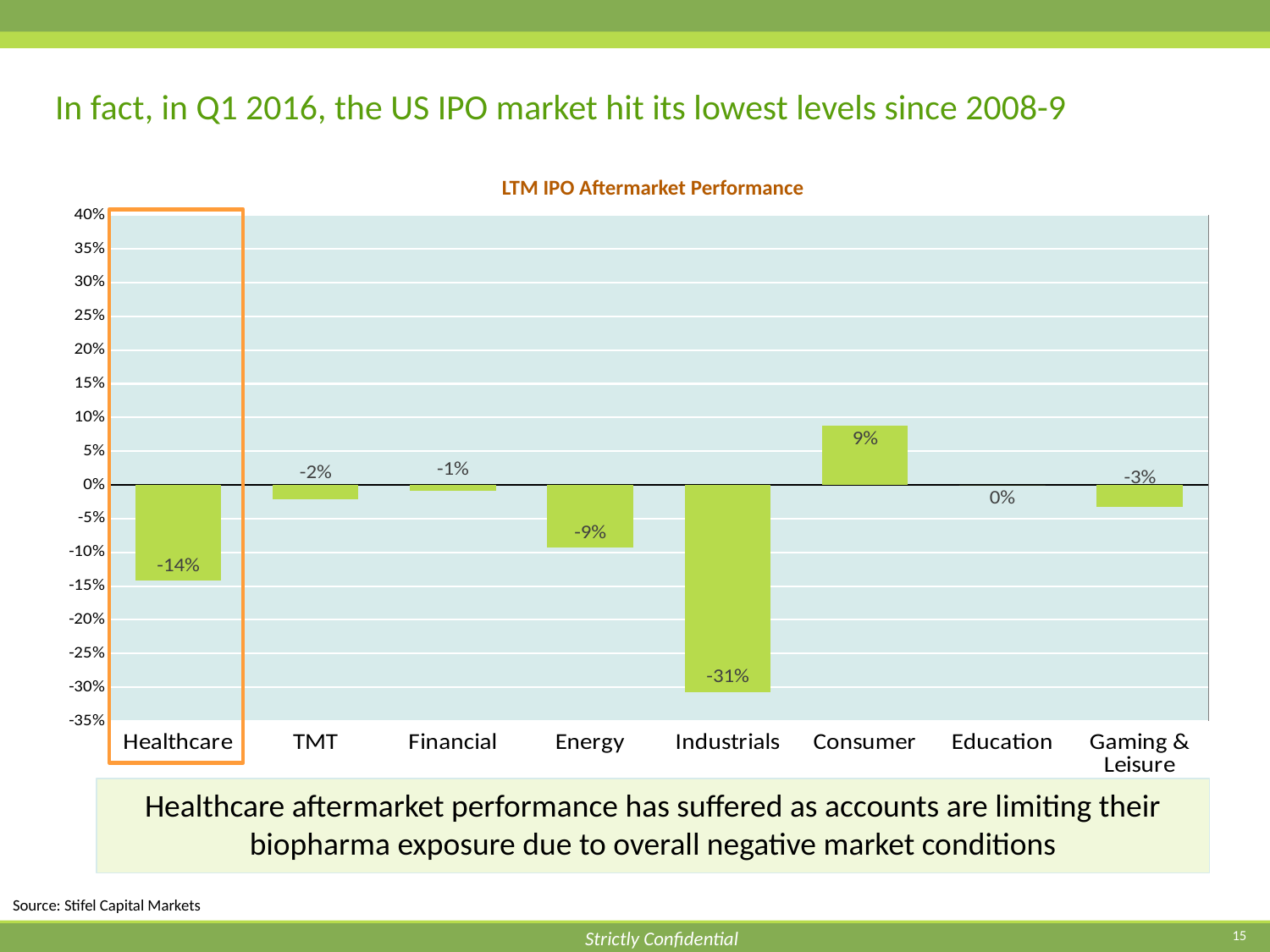
Which sector's bar is highlighted with an orange box? Healthcare What kind of chart is shown on the slide? Bar chart What is the difference between the values for Healthcare and Energy? 5 percentage points Which has the higher value, TMT or Financial? Financial How many sectors are shown on the x axis? 8 Which sector has the highest LTM IPO aftermarket performance? Consumer What is the title of the chart? LTM IPO Aftermarket Performance What is the value shown for Education? 0% What is the value shown for Industrials? -31% What is the value shown for Consumer? 9% What is the LTM IPO aftermarket performance for Healthcare? -14% Which sector has the lowest LTM IPO aftermarket performance? Industrials